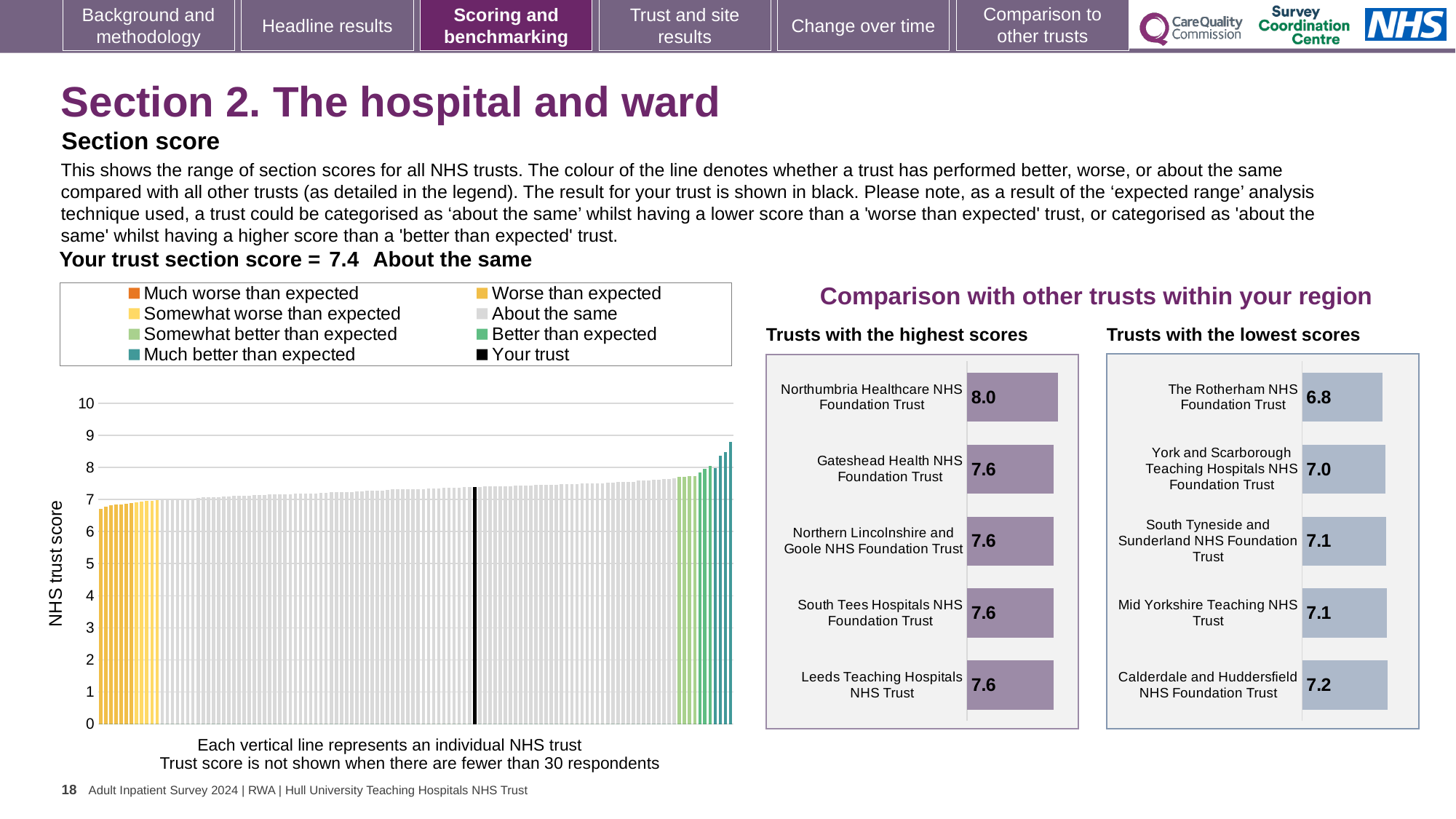
How many entries does the legend of the large chart on the left list? 8 In the 'Trusts with the lowest scores' chart, what is the difference between the scores of Calderdale and Huddersfield NHS Foundation Trust and The Rotherham NHS Foundation Trust? 0.4 In the 'Trusts with the lowest scores' chart, which trust has the lowest score? The Rotherham NHS Foundation Trust In the 'Trusts with the highest scores' chart, what is the score for Northumbria Healthcare NHS Foundation Trust? 8.0 How many trusts are shown in the 'Trusts with the lowest scores' chart? 5 In the 'Trusts with the highest scores' chart, what is the difference between the scores of Northumbria Healthcare NHS Foundation Trust and Gateshead Health NHS Foundation Trust? 0.4 In the 'Trusts with the highest scores' chart, which has the larger score: Northumbria Healthcare NHS Foundation Trust or Leeds Teaching Hospitals NHS Trust? Northumbria Healthcare NHS Foundation Trust In the 'Trusts with the lowest scores' chart, what is the score for The Rotherham NHS Foundation Trust? 6.8 What kind of chart is the large chart on the left showing NHS trust scores? Bar chart How many trusts are shown in the 'Trusts with the highest scores' chart? 5 In the 'Trusts with the highest scores' chart, which trust has the highest score? Northumbria Healthcare NHS Foundation Trust In the 'Trusts with the lowest scores' chart, what is the score for Calderdale and Huddersfield NHS Foundation Trust? 7.2